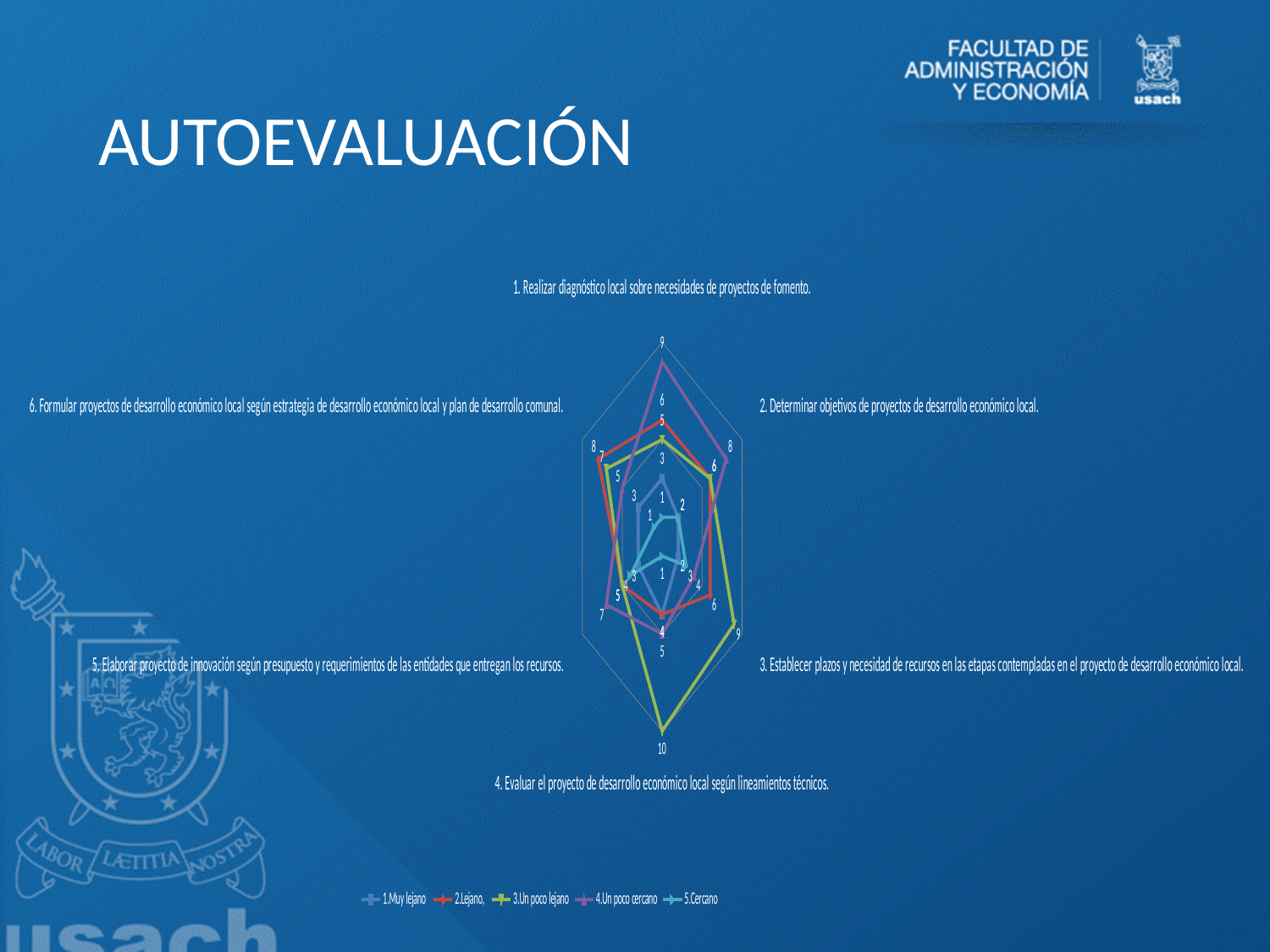
What kind of chart is shown on the slide? Radar chart What is the title of the slide containing the chart? AUTOEVALUACIÓN What is the highest value plotted anywhere on the radar chart? 10 What is the value for the series 3.Un poco lejano on the axis '4. Evaluar el proyecto de desarrollo económico local según lineamientos técnicos.'? 10 What is the value for the series 4.Un poco cercano on the axis '1. Realizar diagnóstico local sobre necesidades de proyectos de fomento.'? 9 How many categories (axes) does the radar chart have? 6 How many series does the legend list? 5 Is the value for 3.Un poco lejano on axis 4 (Evaluar el proyecto) greater or less than 5? greater Which series reaches the highest value on the axis '4. Evaluar el proyecto de desarrollo económico local según lineamientos técnicos.'? 3.Un poco lejano Which legend entry is listed last? 5.Cercano